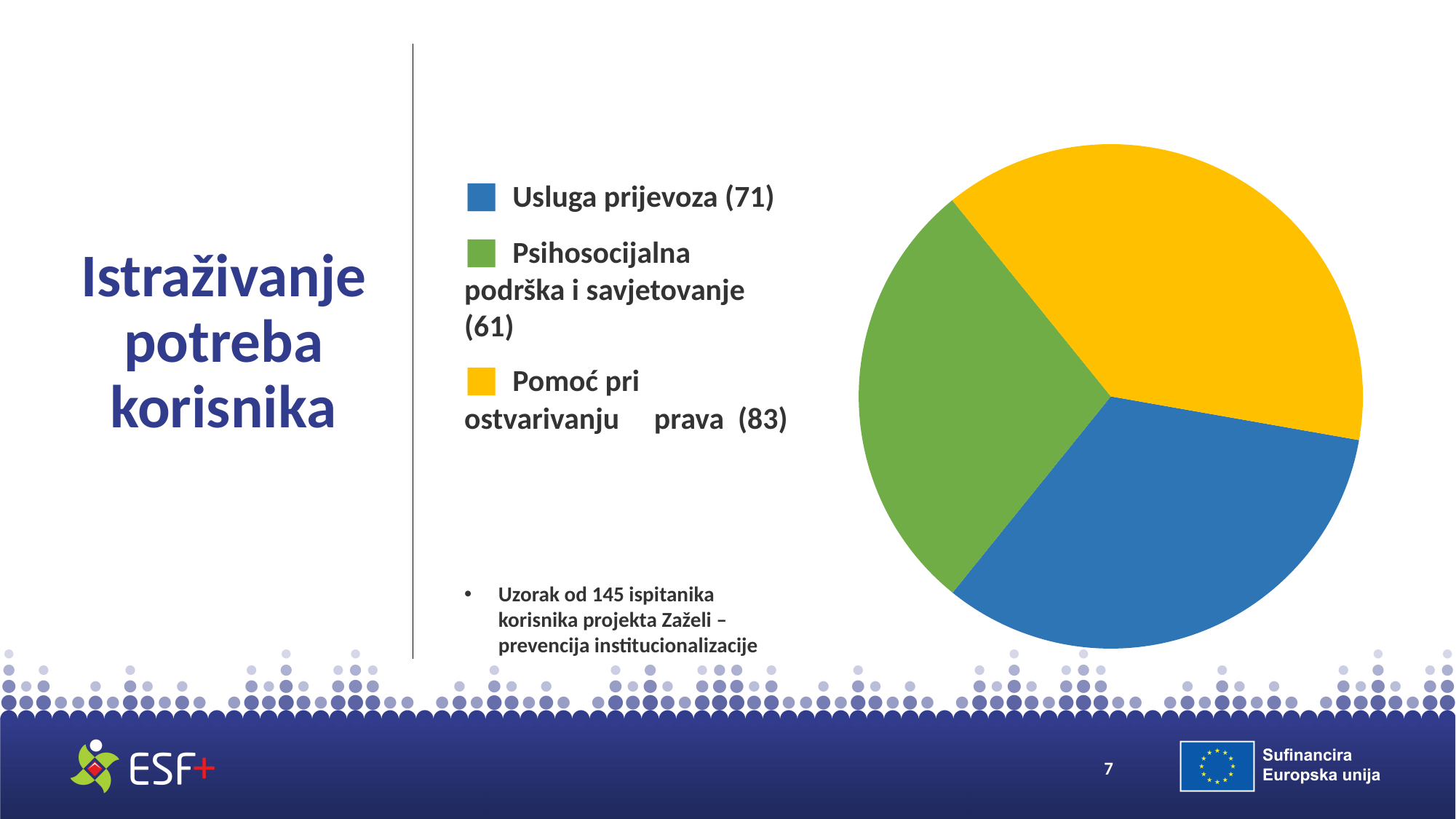
What is the value for Usluga prijevoza in the pie chart? 71 What kind of chart is shown on the slide? Pie chart What is the value for Psihosocijalna podrška i savjetovanje in the pie chart? 61 Which category has the lowest value in the pie chart? Psihosocijalna podrška i savjetovanje What is the difference between the values for Pomoć pri ostvarivanju prava and Usluga prijevoza? 12 Which is larger: the value for Usluga prijevoza or the value for Psihosocijalna podrška i savjetovanje? Usluga prijevoza What is the difference between the values for Usluga prijevoza and Psihosocijalna podrška i savjetovanje? 10 Which category has the highest value in the pie chart? Pomoć pri ostvarivanju prava How many categories are shown in the pie chart? 3 What is the value for Pomoć pri ostvarivanju prava in the pie chart? 83 What colour represents Pomoć pri ostvarivanju prava in the pie chart? Yellow What is the total of all three values shown in the pie chart? 215